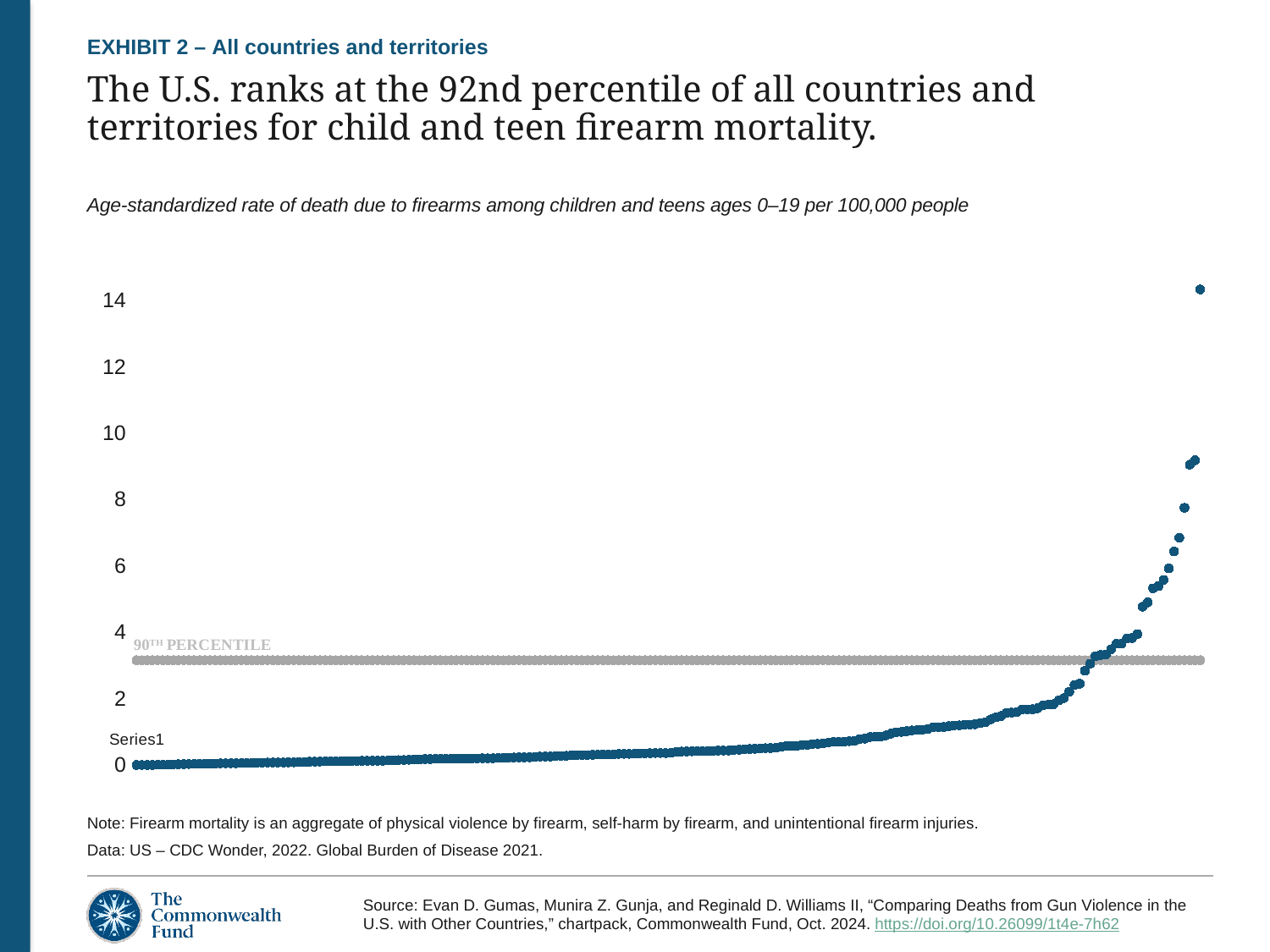
What is the highest value shown on the y axis? 14 Is the highest plotted value greater or less than 12? greater Is the second-highest plotted value greater or less than 10? less Is the second-highest plotted value greater or less than 8? greater What kind of chart is shown on the slide? Scatter (dot) chart Is the highest plotted point above or below the 90th percentile line? Above What does the horizontal dashed reference line on the chart represent? 90th percentile Do the plotted values rise or fall moving from left to right along the x axis? Rise